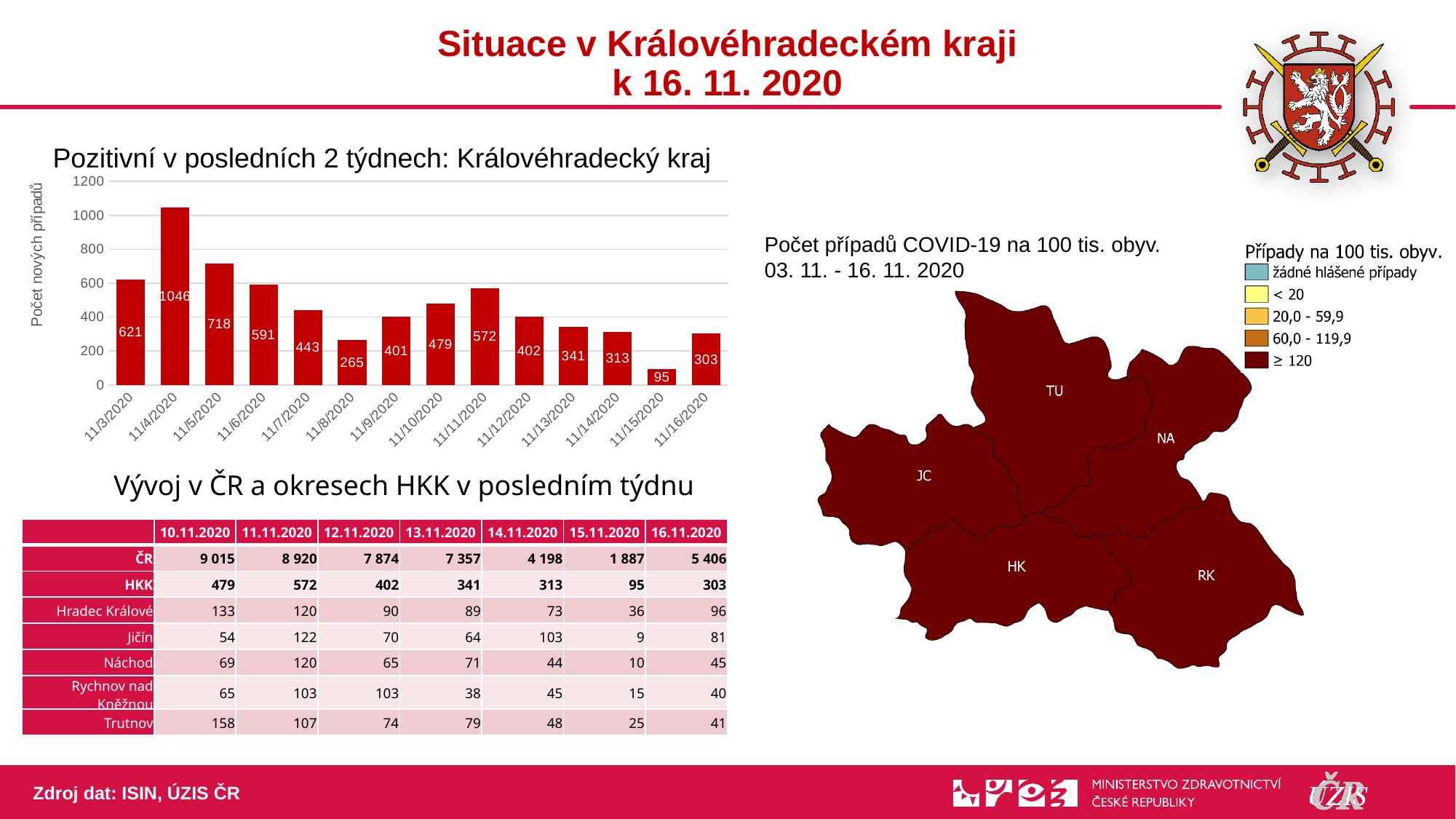
In the bar chart 'Pozitivní v posledních 2 týdnech: Královéhradecký kraj', which date has the lowest value? 11/15/2020 In the bar chart 'Pozitivní v posledních 2 týdnech: Královéhradecký kraj', is the value for 11/11/2020 greater or less than 400? greater In the bar chart 'Pozitivní v posledních 2 týdnech: Královéhradecký kraj', what is the difference between the values for 11/4/2020 and 11/5/2020? 328 In the bar chart 'Pozitivní v posledních 2 týdnech: Královéhradecký kraj', what is the value for 11/4/2020? 1046 In the bar chart 'Pozitivní v posledních 2 týdnech: Královéhradecký kraj', do the values rise or fall from 11/11/2020 to 11/15/2020? fall In the bar chart 'Pozitivní v posledních 2 týdnech: Královéhradecký kraj', what is the value for 11/8/2020? 265 In the bar chart 'Pozitivní v posledních 2 týdnech: Královéhradecký kraj', which date has the highest value? 11/4/2020 What is the y-axis label of the bar chart 'Pozitivní v posledních 2 týdnech: Královéhradecký kraj'? Počet nových případů How many dates (bars) are shown in the bar chart 'Pozitivní v posledních 2 týdnech: Královéhradecký kraj'? 14 In the bar chart 'Pozitivní v posledních 2 týdnech: Královéhradecký kraj', what is the value for 11/16/2020? 303 What kind of chart is 'Pozitivní v posledních 2 týdnech: Královéhradecký kraj'? bar chart In the bar chart 'Pozitivní v posledních 2 týdnech: Královéhradecký kraj', which is larger, the value for 11/3/2020 or 11/6/2020? 11/3/2020